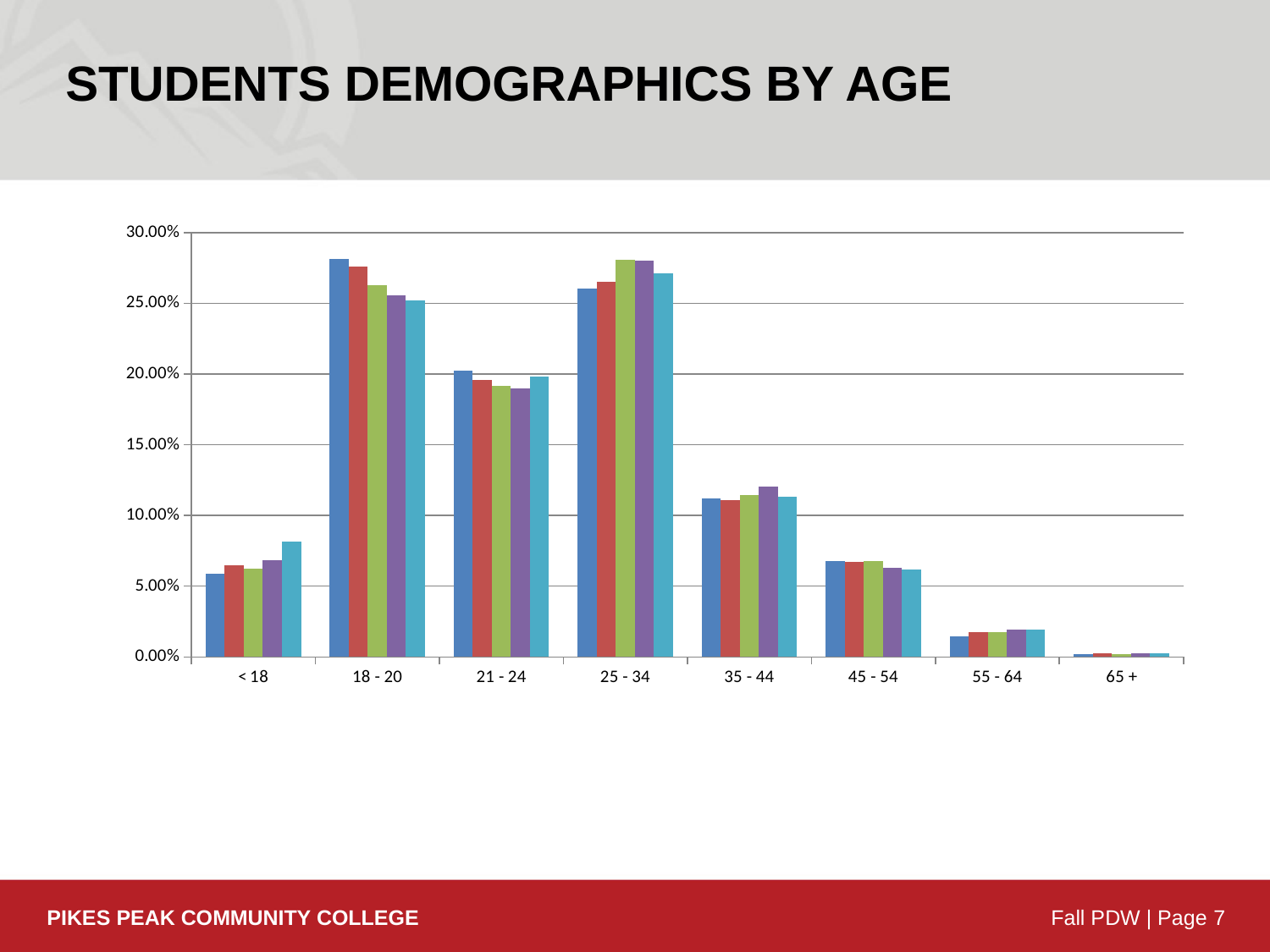
Which has the larger values, the 21 - 24 category or the 55 - 64 category? 21 - 24 How many age categories are shown on the x axis? 8 Is the value of the purple bar for 35 - 44 greater or less than 10%? greater Is the value of the blue bar for 18 - 20 greater or less than 25%? greater Is the value of the blue bar for 65 + greater or less than 5%? less What is the title of the slide's chart? STUDENTS DEMOGRAPHICS BY AGE Which age category has the lowest values across all bars? 65 + Which has the larger values, the 35 - 44 category or the 45 - 54 category? 35 - 44 What kind of chart is shown on the slide? bar chart